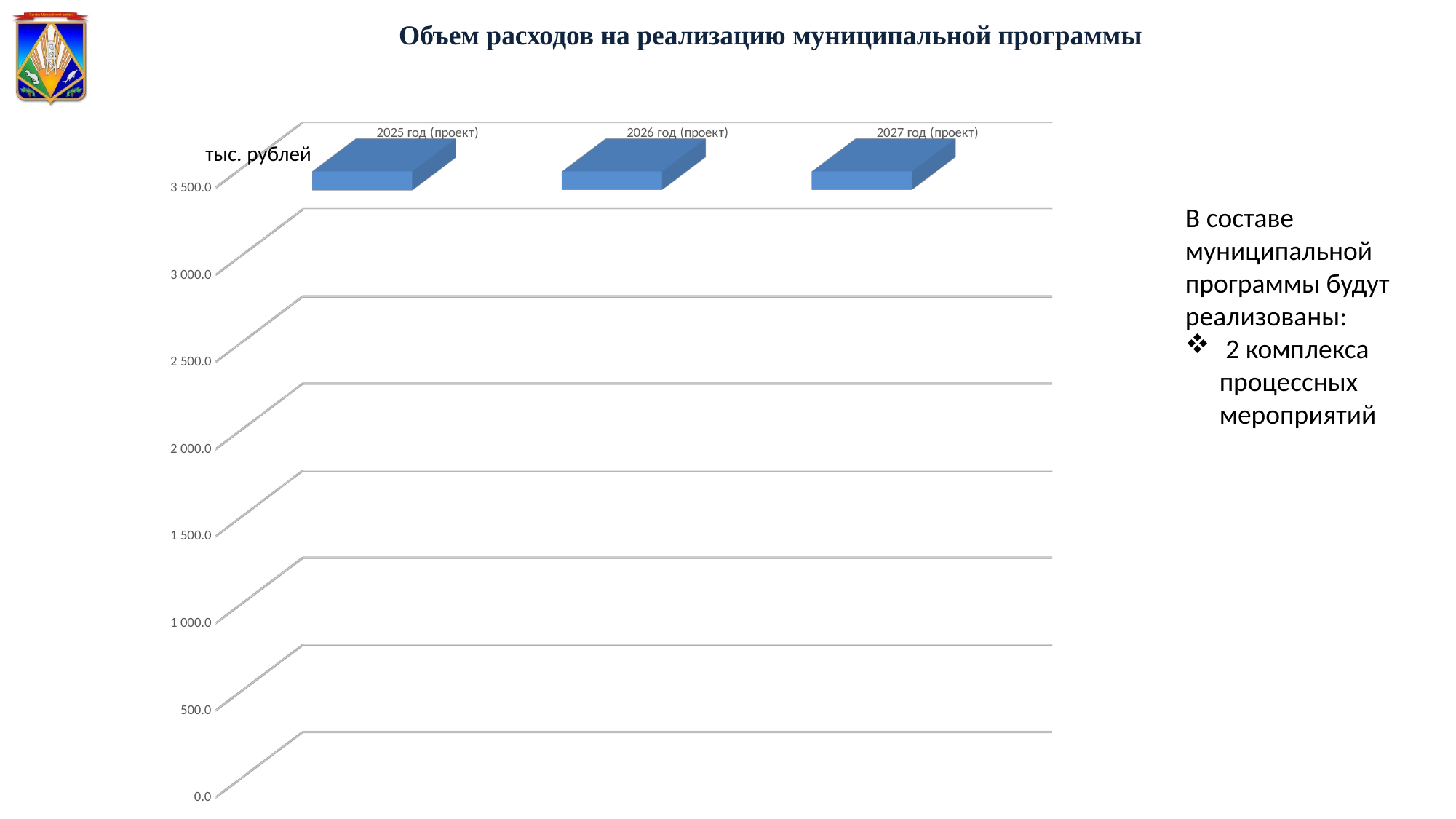
What is the label of the first category in the chart? 2025 год (проект) What is the highest tick value shown on the chart's vertical axis? 3 500.0 What is the label of the last category in the chart? 2027 год (проект) What kind of chart is shown on the slide? bar chart What is the interval between consecutive tick marks on the chart's vertical axis? 500.0 Which year category appears between 2025 год (проект) and 2027 год (проект) in the chart? 2026 год (проект) What unit is indicated for the values on the chart's vertical axis? тыс. рублей What is the lowest tick value shown on the chart's vertical axis? 0.0 How many categories (years) are plotted in the chart? 3 What is the title of the chart on the slide? Объем расходов на реализацию муниципальной программы